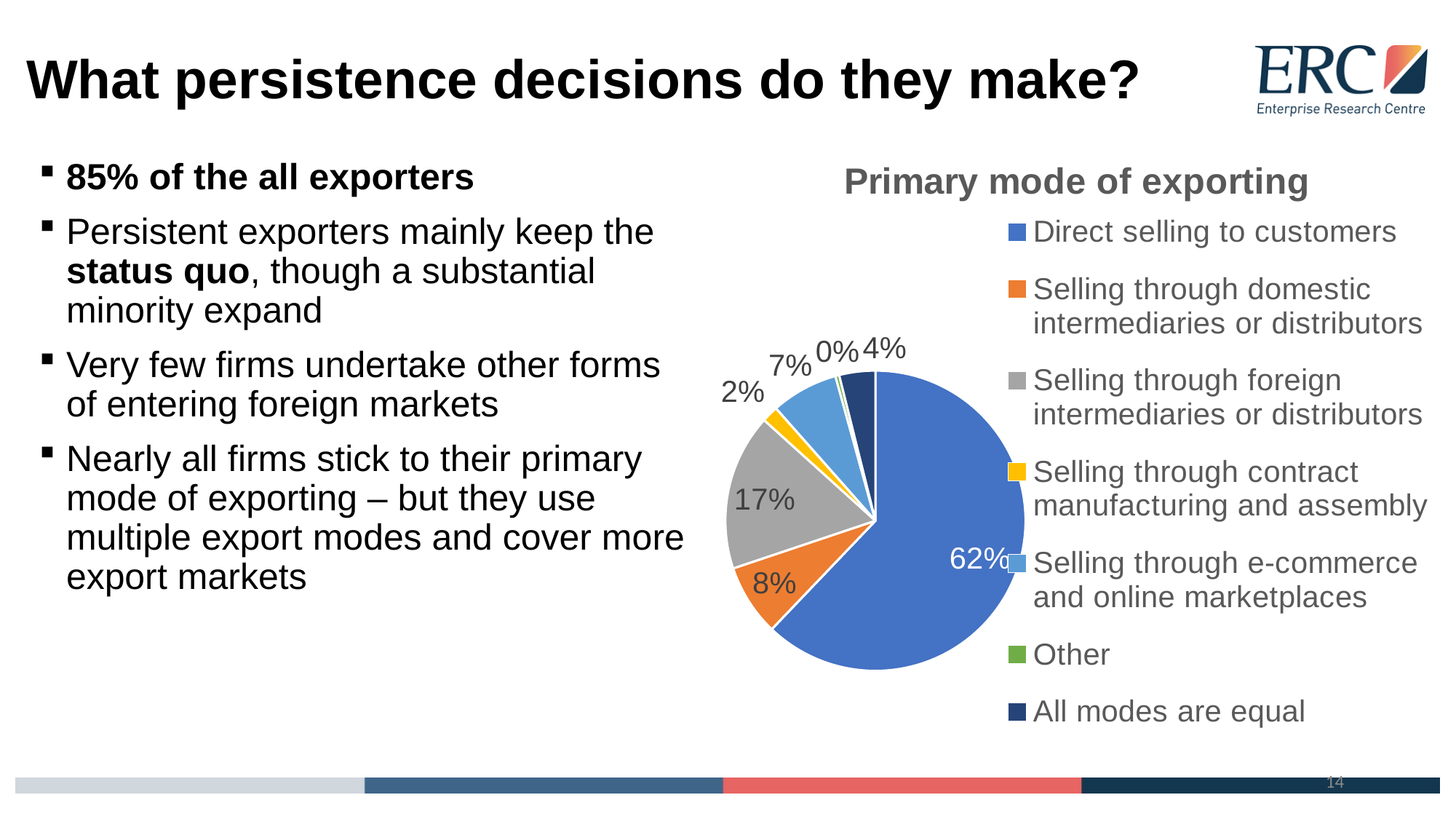
What share of the pie is 'All modes are equal'? 4% What share of the pie is 'Selling through foreign intermediaries or distributors'? 17% Which primary mode of exporting has the smallest share? Other How many categories does the legend list? 7 What is the difference between the share for 'Selling through foreign intermediaries or distributors' and 'Selling through domestic intermediaries or distributors'? 9% What share of the pie is 'Direct selling to customers'? 62% What share of the pie is 'Selling through domestic intermediaries or distributors'? 8% What kind of chart is shown on the slide? Pie chart What share of the pie is 'Selling through e-commerce and online marketplaces'? 7% What is the title of the chart? Primary mode of exporting Which primary mode of exporting has the largest share? Direct selling to customers What share of the pie is 'Other'? 0%